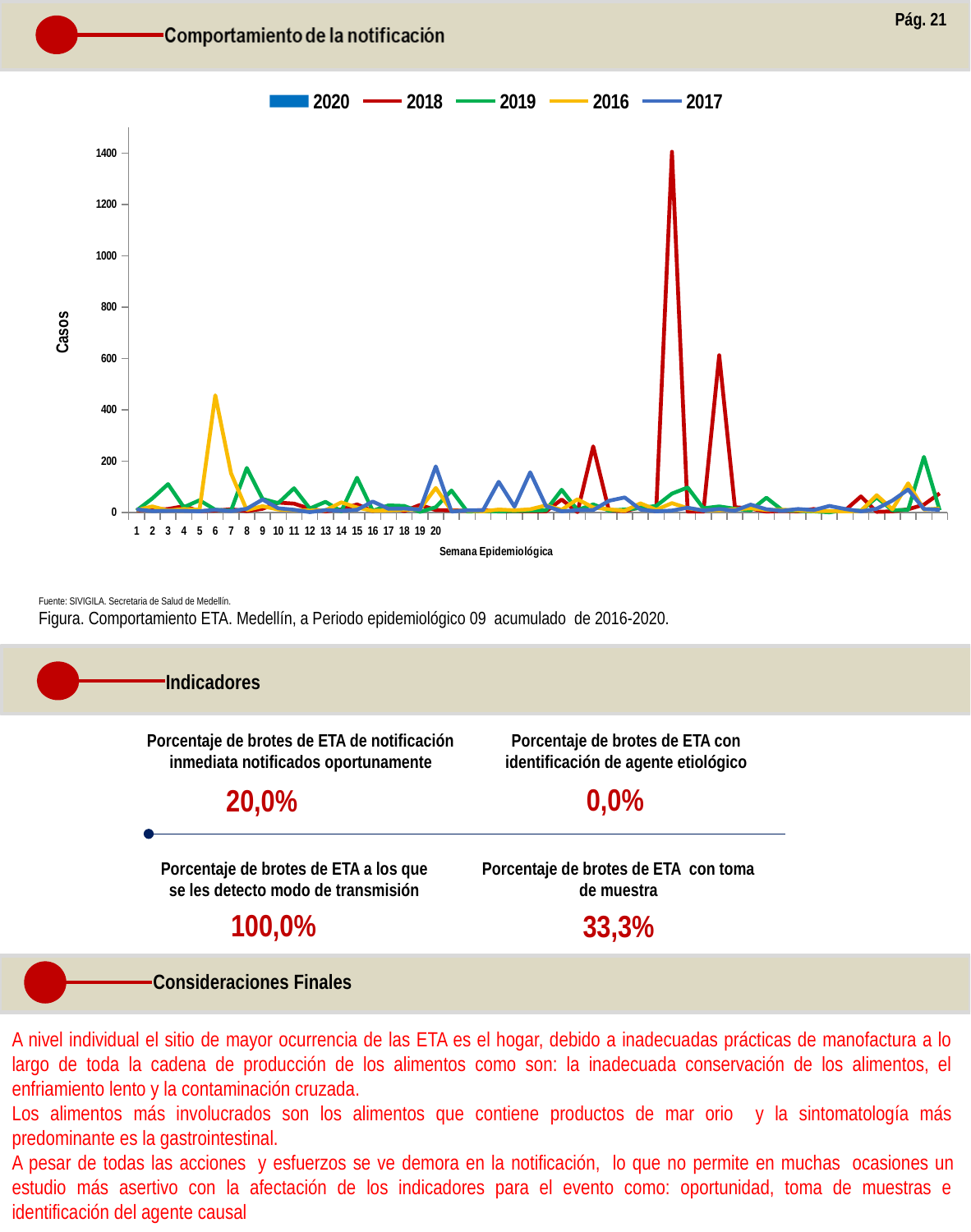
What kind of chart is shown on the slide? combination bar and line chart Is the peak of the 2019 series at week 8 greater or less than 200? less Is the highest peak of the 2018 series greater or less than 1200? greater Is the value of the 2017 series at week 20 greater or less than 400? less What is the highest tick value shown on the y axis? 1400 Which series has the higher peak overall, 2018 or 2016? 2018 What is the title of the x axis of the chart? Semana Epidemiológica How many series does the chart legend list? 5 Which series reaches the highest value on the chart? 2018 Which series has the highest value at week 6, 2016 or 2019? 2016